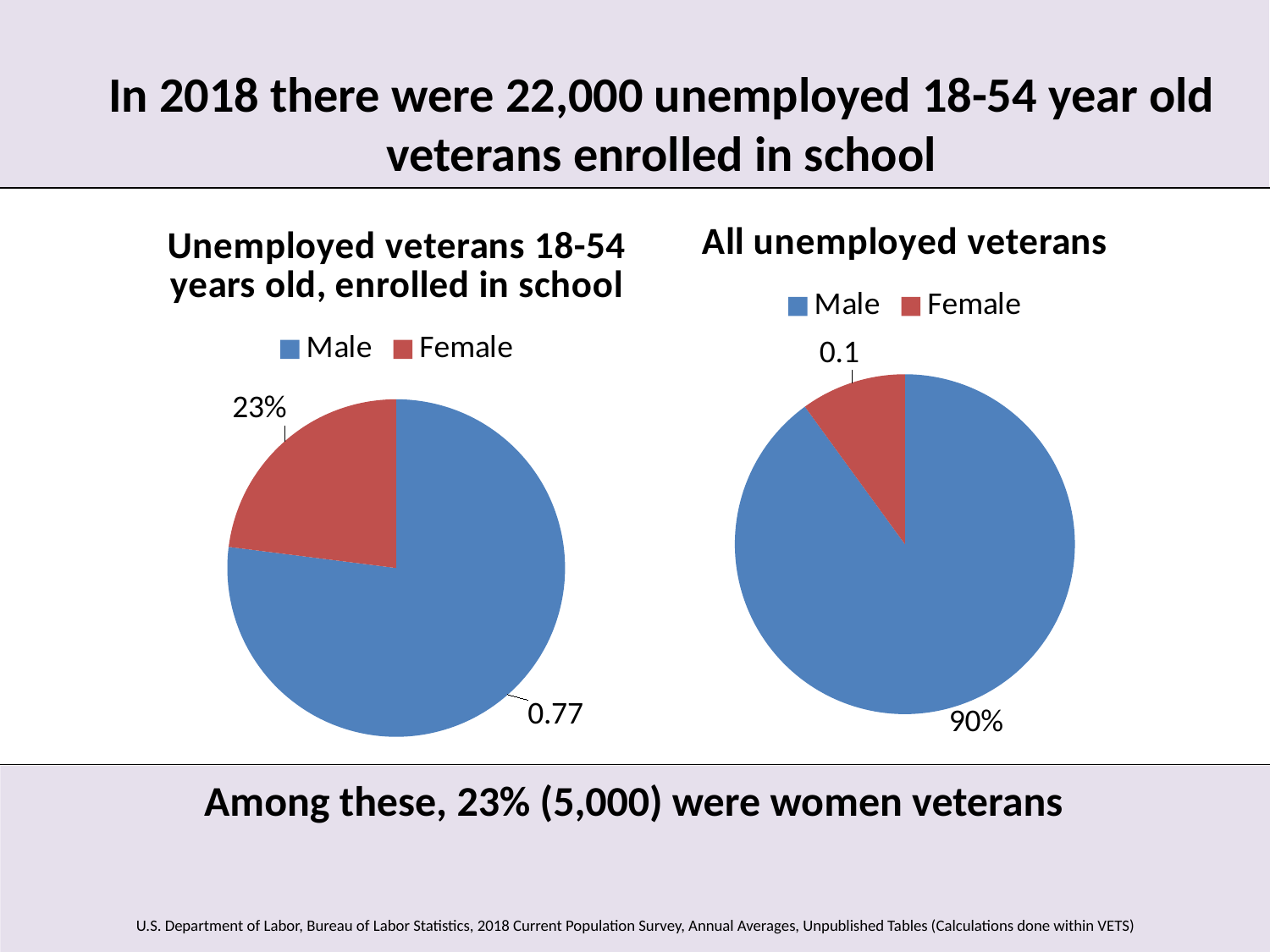
How many slices does the chart titled 'All unemployed veterans' have? 2 What is the title of the chart on the right of the slide? All unemployed veterans In the chart titled 'All unemployed veterans', what colour is the Female slice? Red In the chart titled 'All unemployed veterans', which slice is larger, Male or Female? Male In the chart titled 'Unemployed veterans 18-54 years old, enrolled in school', which category has the largest slice? Male How many entries does the legend of the chart titled 'Unemployed veterans 18-54 years old, enrolled in school' list? 2 What kind of chart is the chart on the left of the slide? Pie chart In the chart titled 'Unemployed veterans 18-54 years old, enrolled in school', what is the value shown for Male? 0.77 In the chart titled 'All unemployed veterans', what is the value shown for Female? 0.1 In the chart titled 'All unemployed veterans', which category has the smallest slice? Female In the chart titled 'All unemployed veterans', what is the value shown for Male? 90% In the chart titled 'Unemployed veterans 18-54 years old, enrolled in school', what is the value shown for Female? 23%